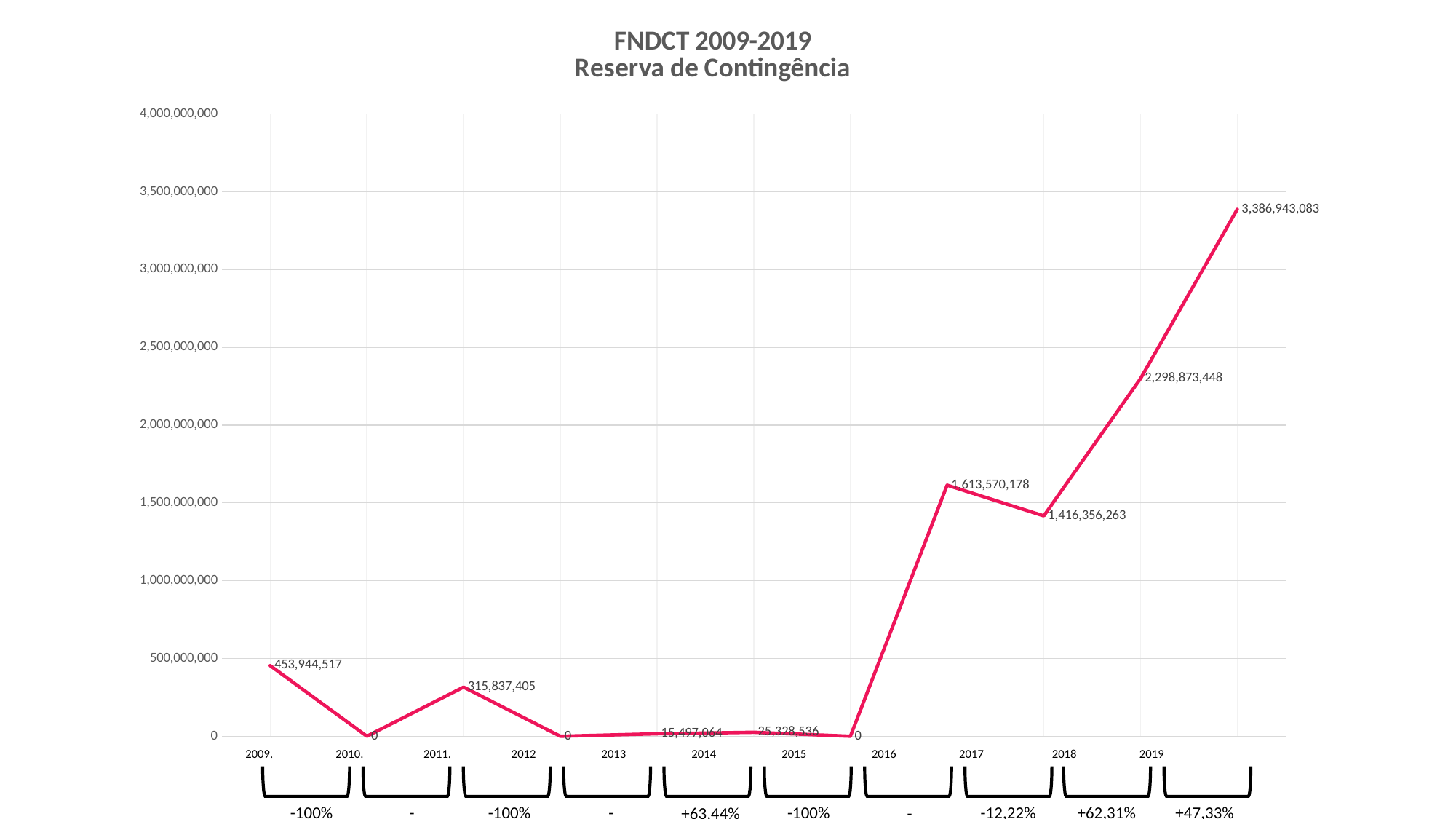
What is the value for 2016? 1,613,570,178 What is the difference between the values for 2016 and 2017? 197,213,915 What is the value for 2011? 315,837,405 What is the title of the chart? FNDCT 2009-2019 Reserva de Contingência How many years have a plotted value of 0? 3 What is the highest value plotted on the chart? 3,386,943,083 What is the value for 2009? 453,944,517 How many data points are plotted on the line? 11 Which is larger, the value for 2009 or the value for 2011? 2009 Is the value for 2018 greater or less than 2,000,000,000? greater What percentage change is shown between 2017 and 2018 below the chart? +62.31% What type of chart is shown on the slide? Line chart